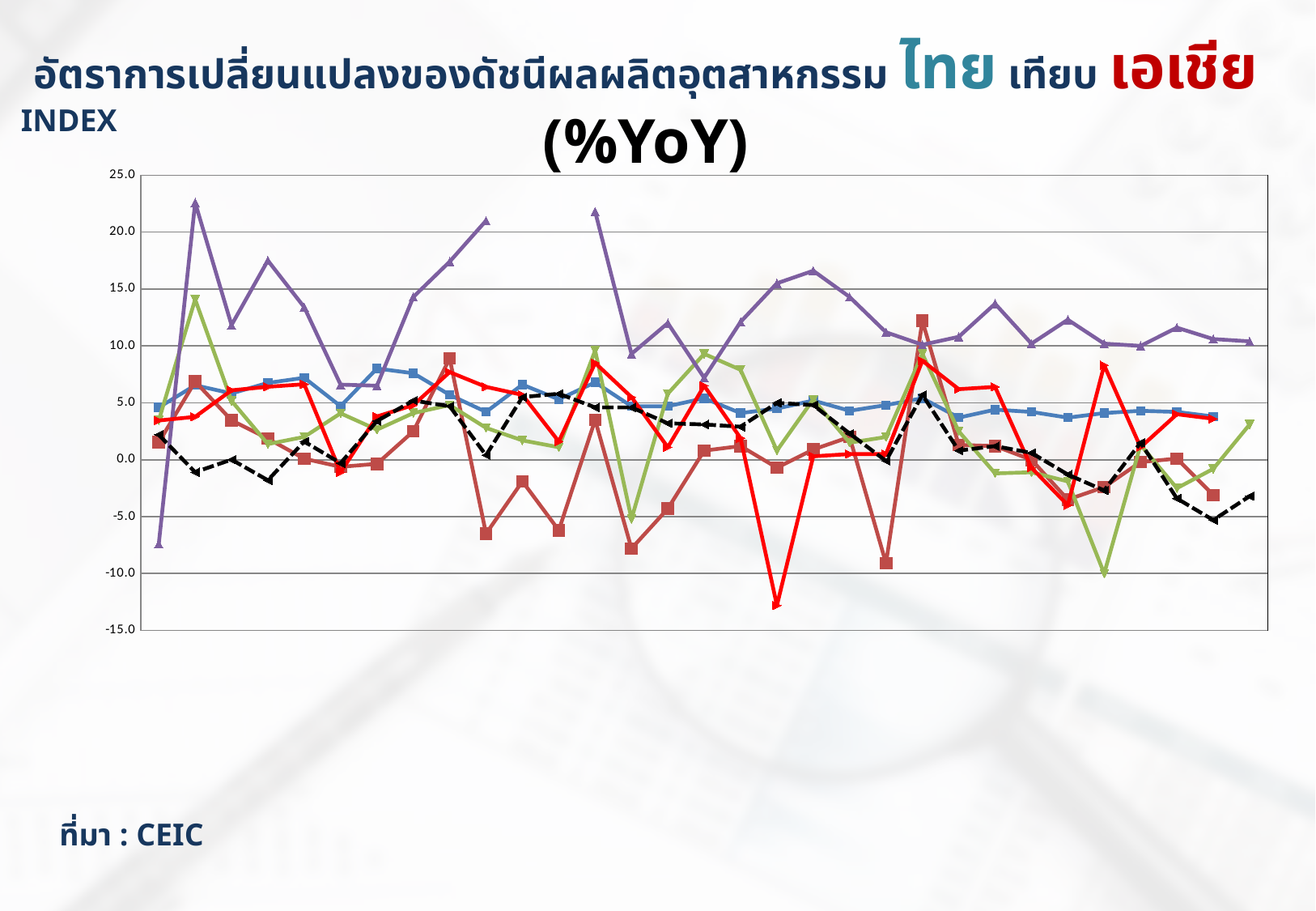
Which coloured line reaches the lowest value on the chart? the solid red line Is the lowest point of the green line greater or less than -5.0? less Is the highest point of the blue line greater or less than 10.0? less Is the highest point of the purple line greater or less than 20.0? greater What source is cited at the bottom of the slide? CEIC Which coloured line reaches the highest value on the chart? the purple line What kind of chart is shown on the slide? line chart What unit is given in the chart title in parentheses? (%YoY)